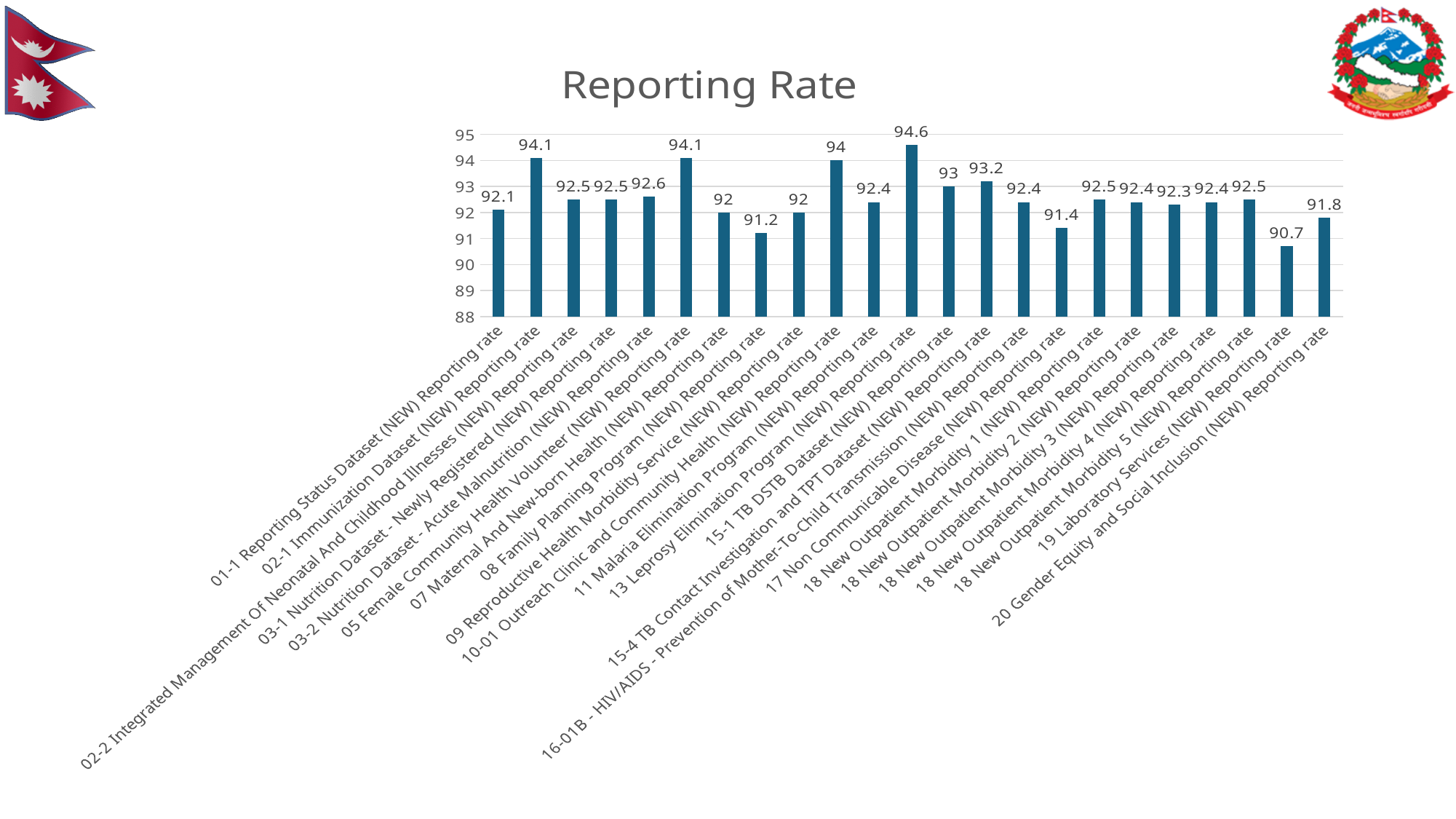
Which category has the highest reporting rate? 13 Leprosy Elimination Program (NEW) Reporting rate Which category has the lowest reporting rate? 19 Laboratory Services (NEW) Reporting rate What is the reporting rate for 08 Family Planning Program (NEW)? 91.2 What is the reporting rate for 19 Laboratory Services (NEW)? 90.7 Is the reporting rate for 10-01 Outreach Clinic and Community Health (NEW) greater or less than 93? greater Which has a higher reporting rate: 02-1 Immunization Dataset (NEW) or 17 Non Communicable Disease (NEW)? 02-1 Immunization Dataset (NEW) Reporting rate What is the reporting rate for 13 Leprosy Elimination Program (NEW)? 94.6 What type of chart is shown on the slide? bar chart What is the difference between the reporting rates of 13 Leprosy Elimination Program (NEW) and 19 Laboratory Services (NEW)? 3.9 What is the reporting rate for 15-4 TB Contact Investigation and TPT Dataset (NEW)? 93.2 What is the title of the chart? Reporting Rate How many categories are shown in the chart? 23